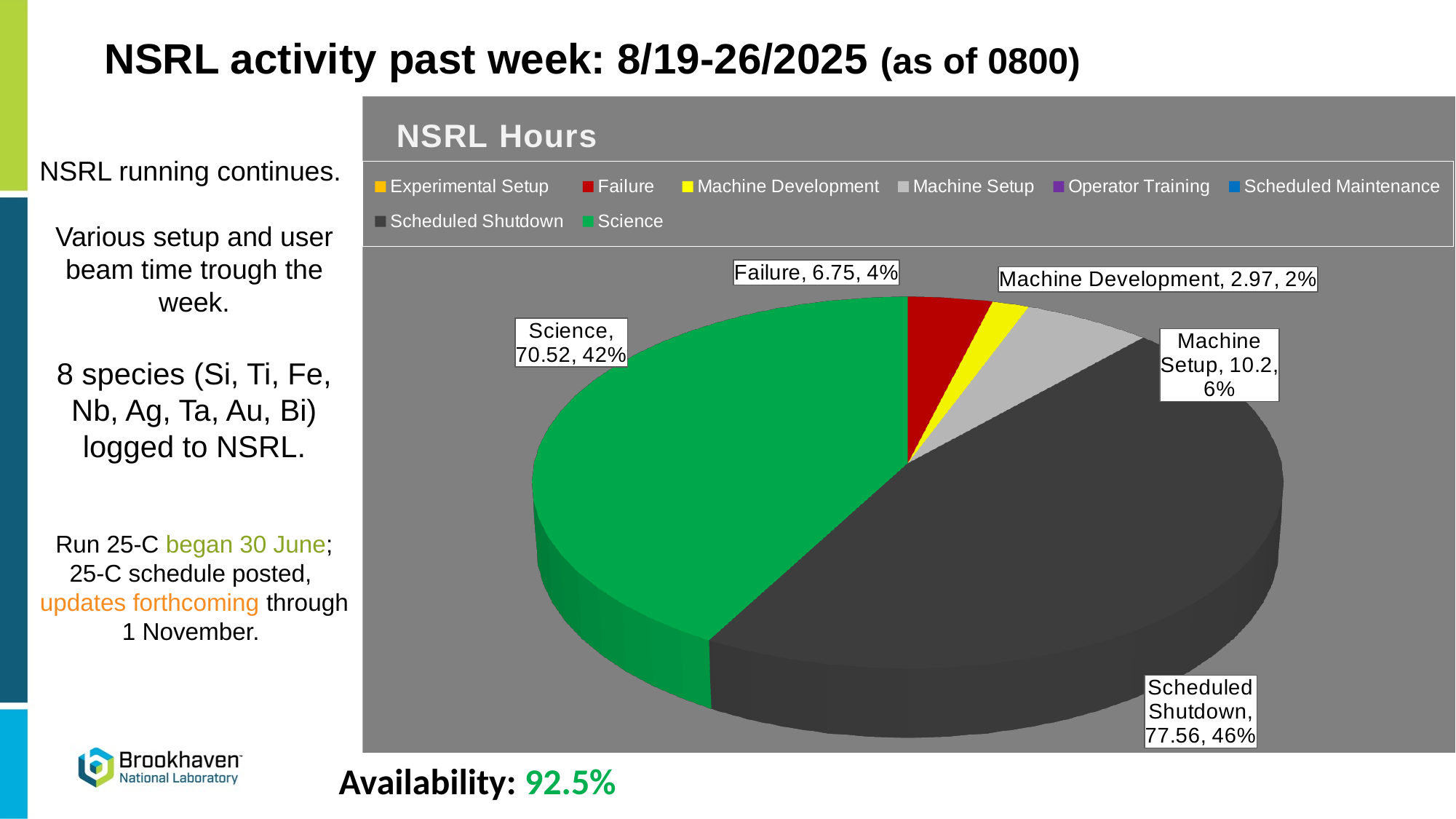
What percentage share of the pie does Failure have? 4% What is the difference in hours between Scheduled Shutdown and Science? 7.04 What kind of chart is shown on the slide? pie chart How many hours are labelled for Science in the NSRL Hours chart? 70.52 What is the title of the chart? NSRL Hours What percentage share of the pie does Machine Development have? 2% How many entries does the chart's legend list? 8 How many hours are labelled for Machine Setup in the NSRL Hours chart? 10.2 Which category has the largest slice in the NSRL Hours chart? Scheduled Shutdown Which labelled category has the smallest slice in the NSRL Hours chart? Machine Development Which has more hours, Machine Setup or Failure? Machine Setup How many hours are labelled for Scheduled Shutdown in the NSRL Hours chart? 77.56